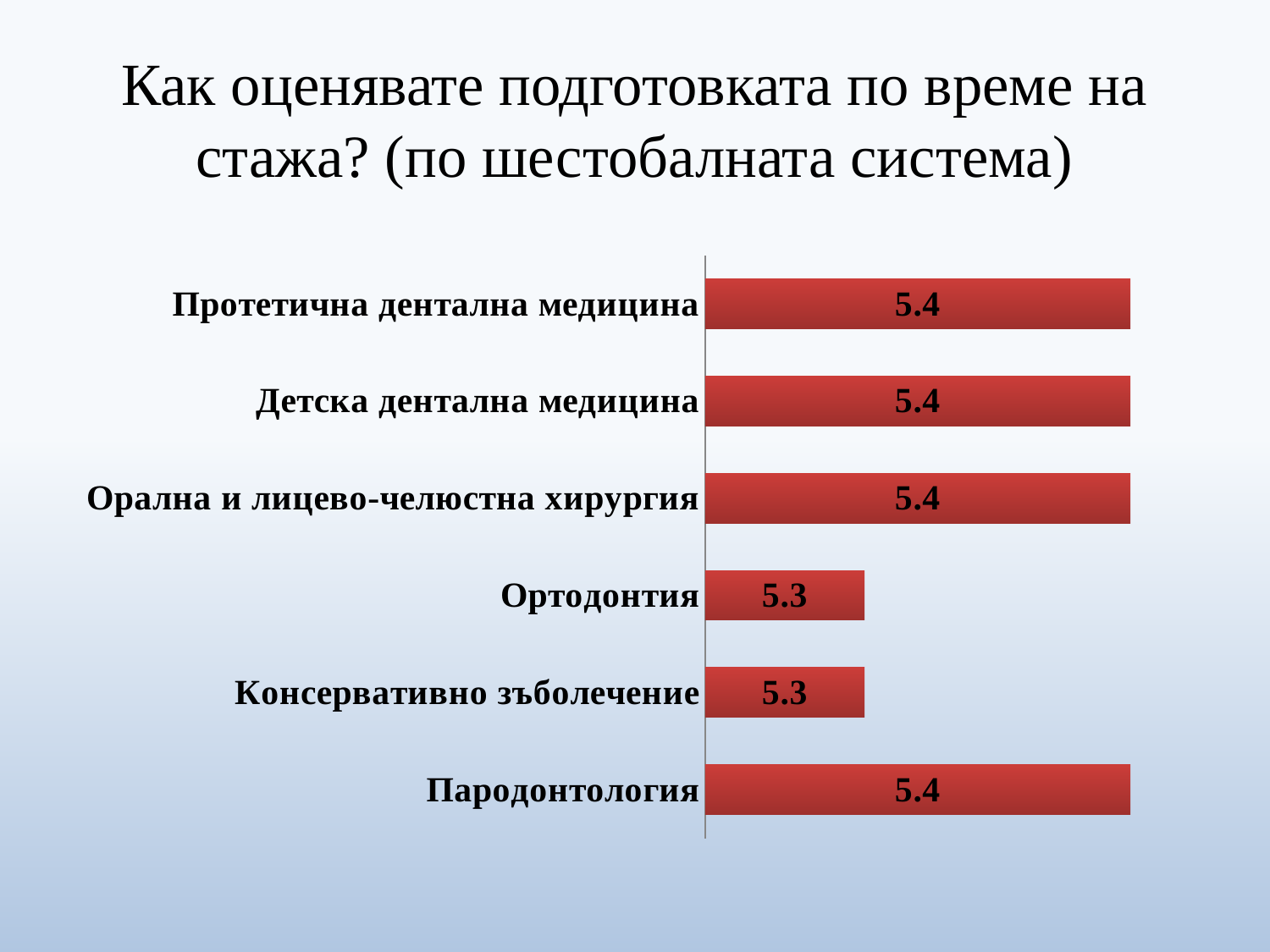
What kind of chart is shown on the slide? Bar chart How many categories are shown in the chart? 6 What is the value for Протетична дентална медицина? 5.4 What is the value for Пародонтология? 5.4 What colour are the bars in the chart? Red Which is larger, the value for Детска дентална медицина or the value for Консервативно зъболечение? Детска дентална медицина How many categories have a value of 5.4? 4 What is the value for Орална и лицево-челюстна хирургия? 5.4 Which categories have the lowest value? Ортодонтия and Консервативно зъболечение What is the difference between the values for Пародонтология and Ортодонтия? 0.1 What is the value for Ортодонтия? 5.3 What is the value for Консервативно зъболечение? 5.3